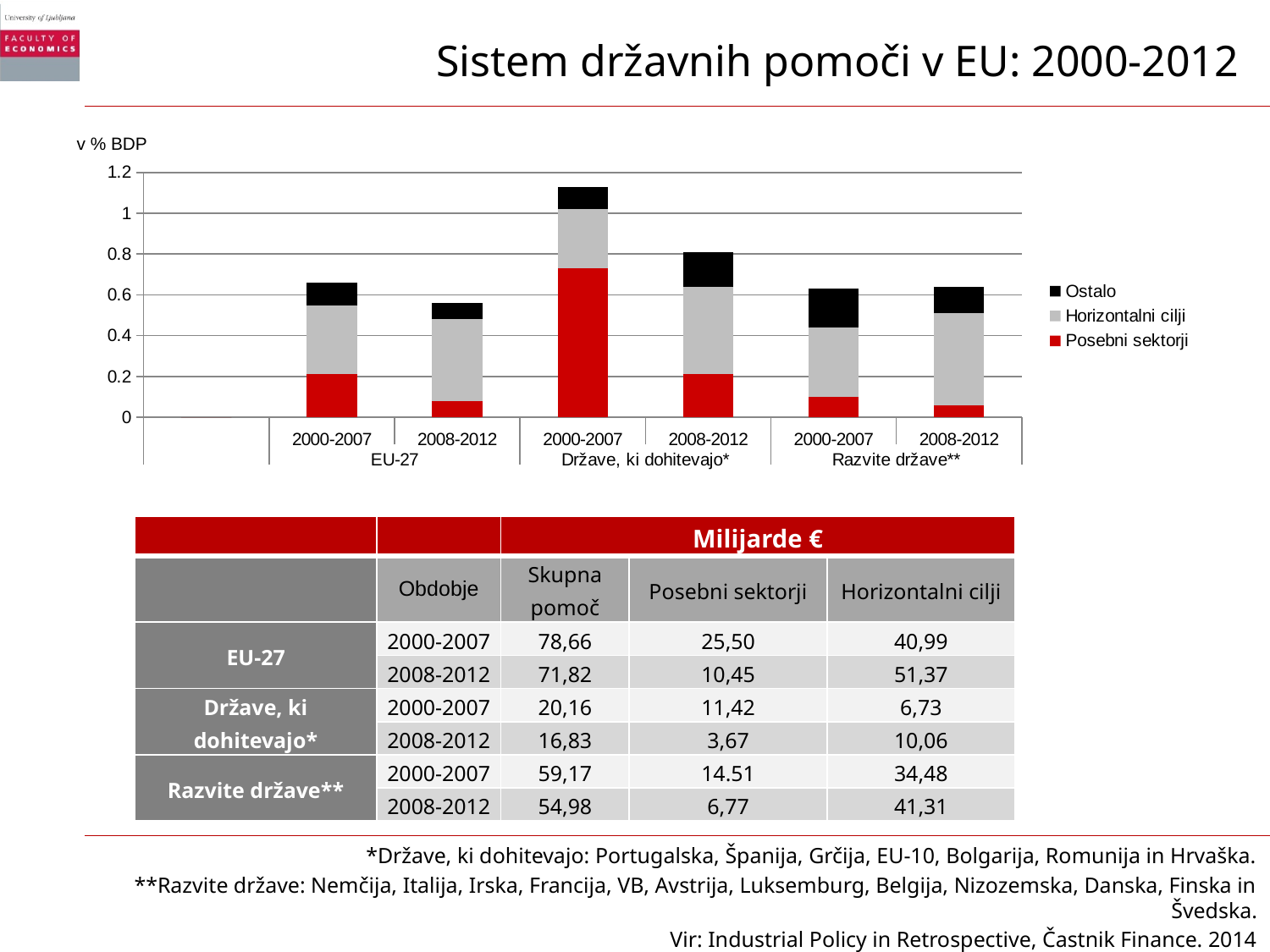
What unit is shown on the vertical axis of the chart? v % BDP Which bar has the highest total in the chart? Države, ki dohitevajo, 2000-2007 For EU-27, does the total bar height rise or fall from 2000-2007 to 2008-2012? fall How many series does the chart legend list? 3 Which colour represents Posebni sektorji in the chart? Red Is the Posebni sektorji value for Države, ki dohitevajo in 2000-2007 greater or less than 0.6? greater Is the Posebni sektorji value for Razvite države in 2008-2012 greater or less than 0.2? less How many bars are plotted in the chart? 6 Which bar has the lowest total in the chart? EU-27, 2008-2012 For EU-27, is the Posebni sektorji segment larger in 2000-2007 or in 2008-2012? 2000-2007 Is the total for Države, ki dohitevajo in 2000-2007 greater or less than 1? greater What kind of chart is shown on the slide? Stacked bar chart